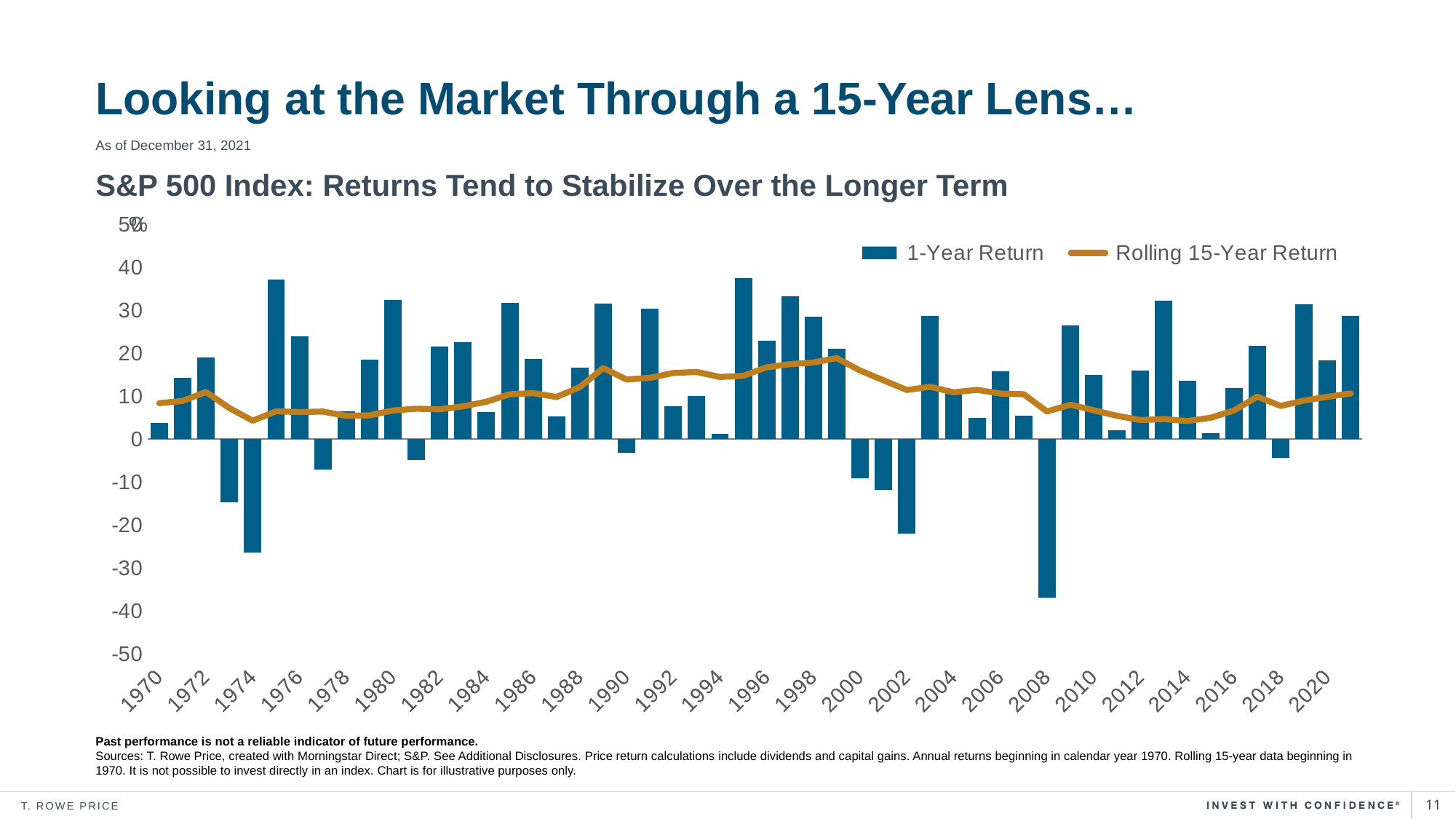
Does the Rolling 15-Year Return line rise or fall between 1999 and 2008? fall What are the two series named in the legend? 1-Year Return and Rolling 15-Year Return Which is larger, the 1-Year Return for 1974 or for 2008? 1974 Is the Rolling 15-Year Return in 1999 greater or less than 10? greater Is the 1-Year Return for 2008 greater or less than -30? less Which year has the lowest 1-Year Return bar? 2008 How many series does the legend list? 2 Is the 1-Year Return for 1974 greater or less than -20? less What is the title of the chart? S&P 500 Index: Returns Tend to Stabilize Over the Longer Term What kind of chart is shown on the slide? A bar chart with a line overlay